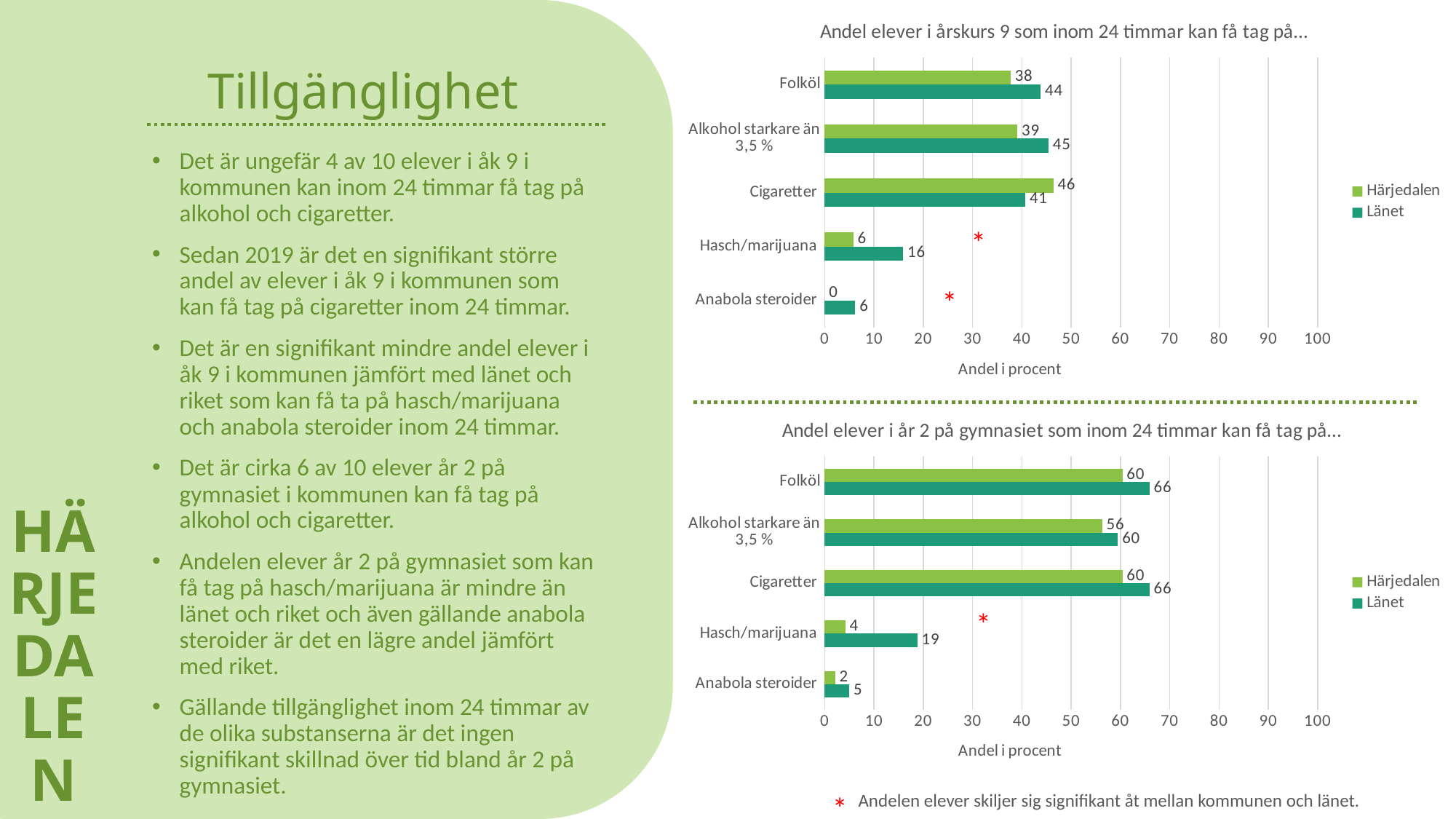
What type of chart is the bottom chart (år 2 på gymnasiet)? Bar chart In the top chart (årskurs 9), what is the difference between Länet and Härjedalen for Folköl? 6 In the top chart (årskurs 9), which category has the lowest value for Härjedalen? Anabola steroider In the top chart (årskurs 9), which category has the highest value for Länet? Alkohol starkare än 3,5 % In the top chart (årskurs 9), what is the value for Länet for Hasch/marijuana? 16 In the bottom chart (år 2 på gymnasiet), what is the difference between Länet and Härjedalen for Hasch/marijuana? 15 How many series does the legend of the top chart (årskurs 9) list? 2 How many categories are shown in the bottom chart (år 2 på gymnasiet)? 5 In the top chart (årskurs 9), what is the value for Härjedalen for Cigaretter? 46 In the bottom chart (år 2 på gymnasiet), what is the value for Härjedalen for Hasch/marijuana? 4 In the top chart (årskurs 9), which is larger for Cigaretter, Härjedalen or Länet? Härjedalen In the bottom chart (år 2 på gymnasiet), what is the value for Länet for Folköl? 66